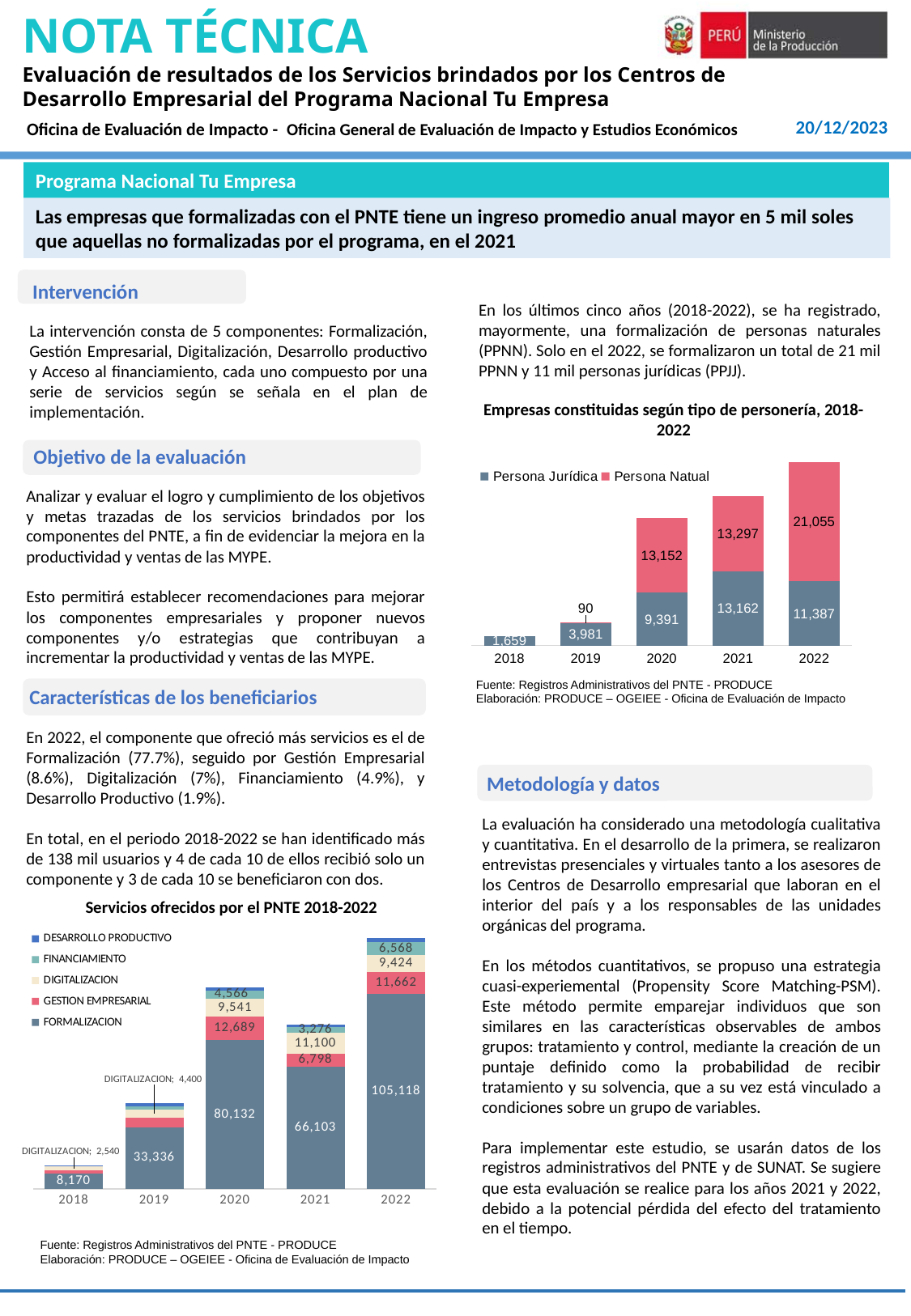
What kind of chart is 'Servicios ofrecidos por el PNTE 2018-2022'? Stacked bar chart In the chart 'Servicios ofrecidos por el PNTE 2018-2022', what is the value for FORMALIZACION in 2022? 105,118 In the chart 'Empresas constituidas según tipo de personería, 2018-2022', what is the difference between Persona Natual and Persona Jurídica in 2022? 9,668 In the chart 'Empresas constituidas según tipo de personería, 2018-2022', what is the value for Persona Natual in 2022? 21,055 In the chart 'Empresas constituidas según tipo de personería, 2018-2022', how many series does the legend list? 2 In the chart 'Servicios ofrecidos por el PNTE 2018-2022', which year has the lowest FORMALIZACION value? 2018 In the chart 'Empresas constituidas según tipo de personería, 2018-2022', what is the total of the stacked bar for 2021? 26,459 In the chart 'Servicios ofrecidos por el PNTE 2018-2022', what is the value for GESTION EMPRESARIAL in 2020? 12,689 In the chart 'Empresas constituidas según tipo de personería, 2018-2022', which year has the highest Persona Natual value? 2022 In the chart 'Empresas constituidas según tipo de personería, 2018-2022', what is the value for Persona Jurídica in 2021? 13,162 In the chart 'Servicios ofrecidos por el PNTE 2018-2022', how many series does the legend list? 5 In the chart 'Servicios ofrecidos por el PNTE 2018-2022', what is the difference between the FORMALIZACION values for 2022 and 2021? 39,015